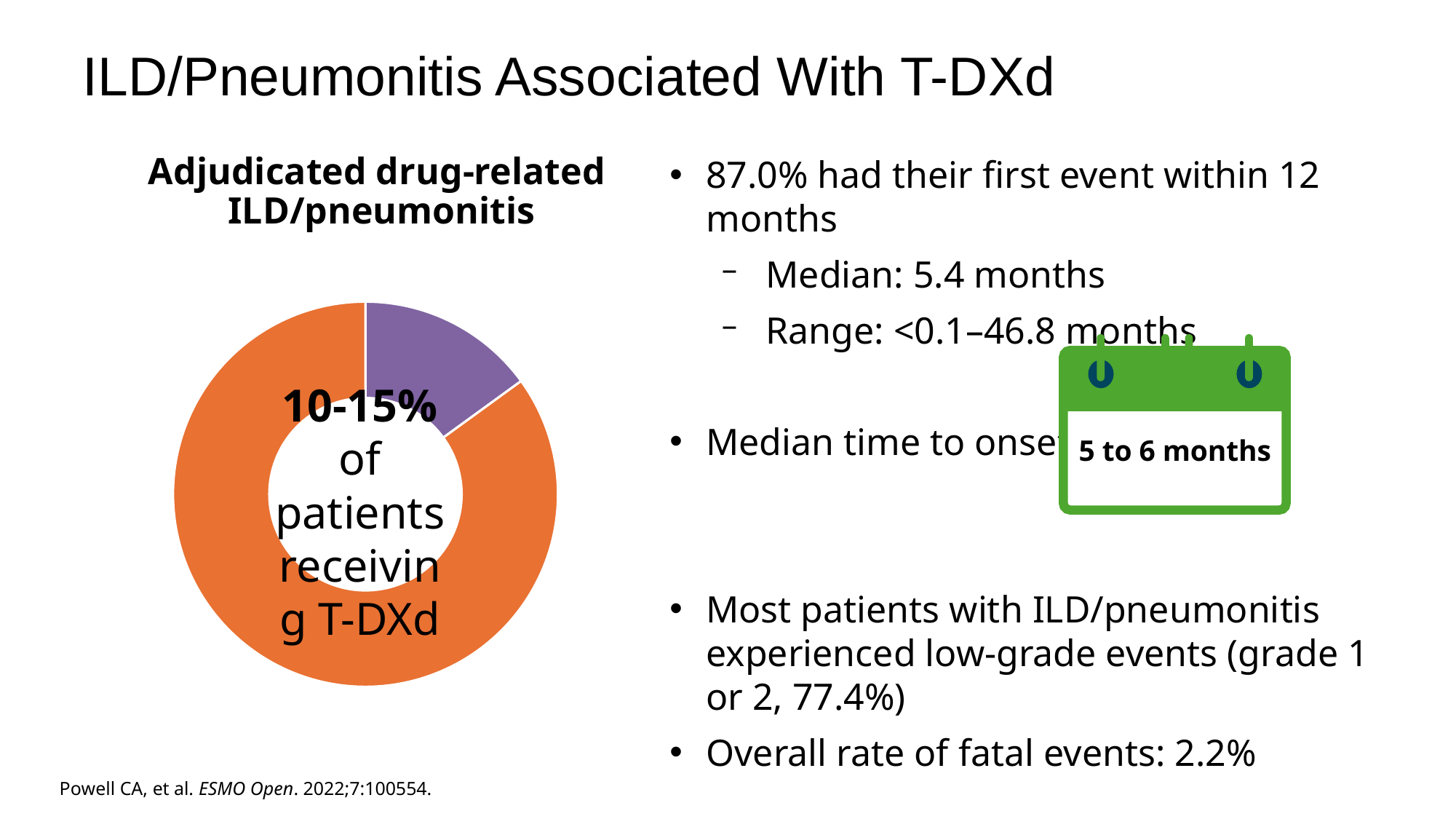
Which slice of the donut chart is larger, the orange one or the purple one? Orange Is the orange slice of the donut chart greater or less than 50% of the whole? greater What two colours are used for the slices of the donut chart? Orange and purple How many slices does the donut chart have? 2 What percentage is printed in the centre of the donut chart? 10-15% Which slice of the donut chart is the smallest? The purple slice According to the text in the centre of the donut chart, what share of patients receiving T-DXd does the highlighted slice represent? 10-15% What is the title of the donut chart? Adjudicated drug-related ILD/pneumonitis What kind of chart is shown on the left of the slide? Pie (donut) chart Is the purple slice of the donut chart greater or less than 50% of the whole? less